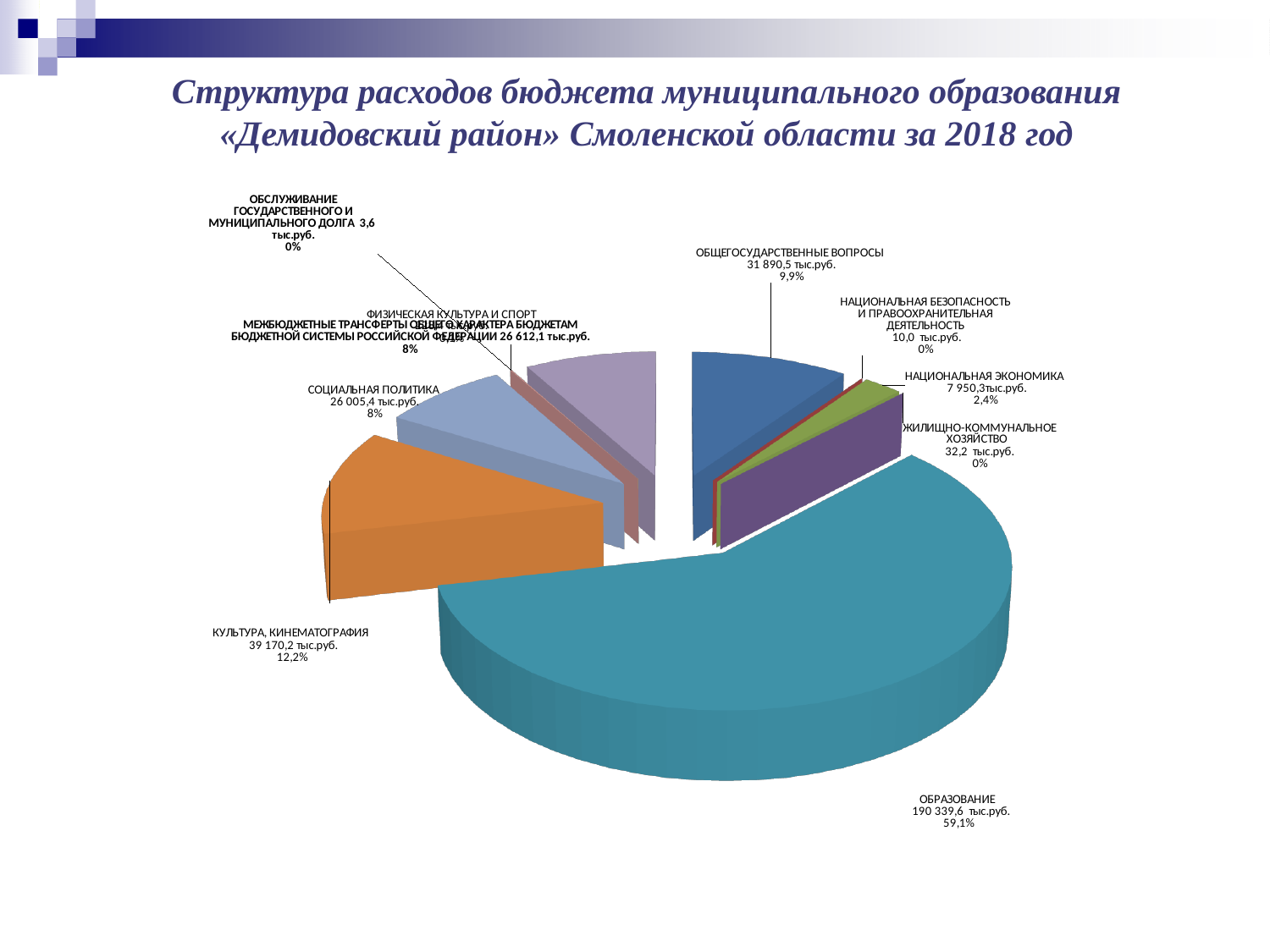
Which category has the largest slice of the pie? ОБРАЗОВАНИЕ What share of the pie does ЖИЛИЩНО-КОММУНАЛЬНОЕ ХОЗЯЙСТВО take? 0% What year does the chart title say the budget expenditure structure is for? 2018 What kind of chart is shown on the slide? Pie chart What is the value for СОЦИАЛЬНАЯ ПОЛИТИКА? 26 005,4 тыс.руб. What is the value for ОБРАЗОВАНИЕ? 190 339,6 тыс.руб. What is the value for НАЦИОНАЛЬНАЯ ЭКОНОМИКА? 7 950,3 тыс.руб. What is the value for КУЛЬТУРА, КИНЕМАТОГРАФИЯ? 39 170,2 тыс.руб. What share of the pie does ОБРАЗОВАНИЕ take? 59,1% What share of the pie does ОБЩЕГОСУДАРСТВЕННЫЕ ВОПРОСЫ take? 9,9% What is the difference between the values for КУЛЬТУРА, КИНЕМАТОГРАФИЯ and ОБЩЕГОСУДАРСТВЕННЫЕ ВОПРОСЫ? 7 279,7 тыс.руб. Which is larger, КУЛЬТУРА, КИНЕМАТОГРАФИЯ or ОБЩЕГОСУДАРСТВЕННЫЕ ВОПРОСЫ? КУЛЬТУРА, КИНЕМАТОГРАФИЯ